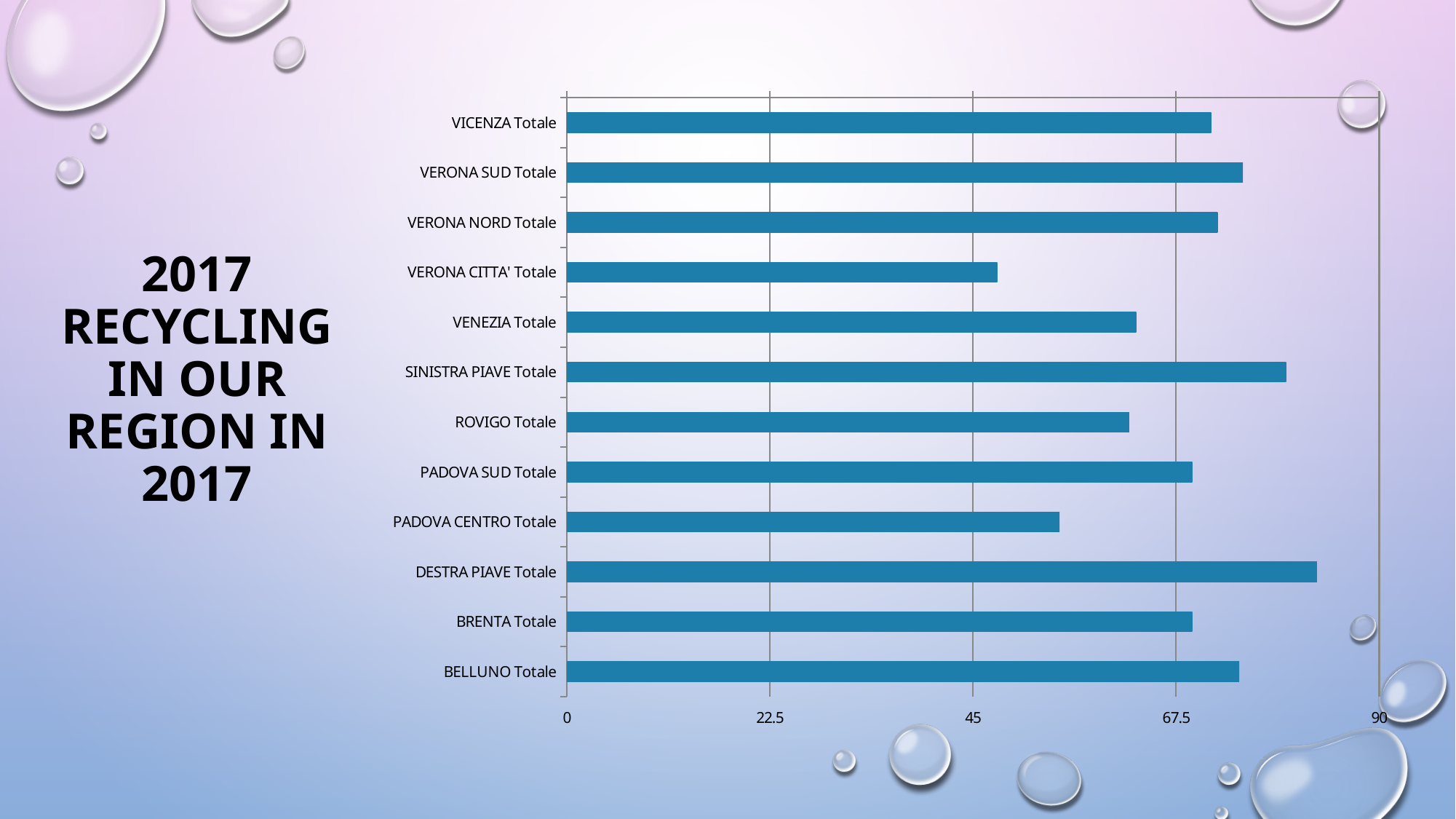
Which is larger, the value for DESTRA PIAVE Totale or SINISTRA PIAVE Totale? DESTRA PIAVE Totale Is the value for DESTRA PIAVE Totale greater or less than 90? less Which is larger, the value for VICENZA Totale or VENEZIA Totale? VICENZA Totale Is the value for VENEZIA Totale greater or less than 67.5? less How many categories are plotted in the chart? 12 What is the title text shown on the slide next to the chart? 2017 RECYCLING IN OUR REGION IN 2017 What kind of chart is shown on the slide? bar chart Which category has the highest value in the chart? DESTRA PIAVE Totale Which category has the lowest value in the chart? VERONA CITTA' Totale Is the value for DESTRA PIAVE Totale greater or less than 67.5? greater